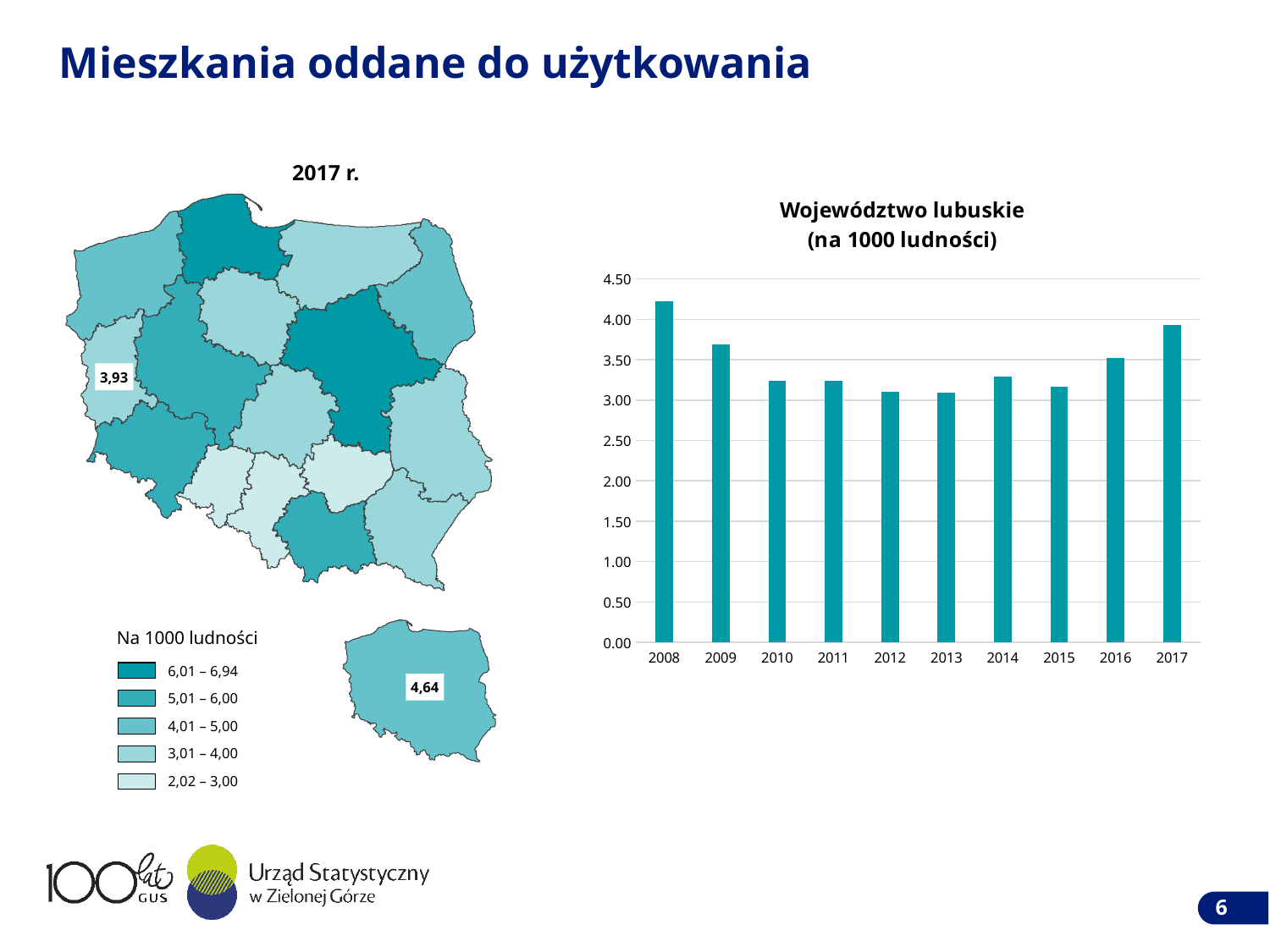
In the 'Województwo lubuskie' bar chart, do the values generally rise or fall from 2013 to 2017? rise In the 'Województwo lubuskie' bar chart, is the value for 2008 greater or less than 4.00? greater How many years are shown on the x axis of the 'Województwo lubuskie' bar chart? 10 In the 'Województwo lubuskie' bar chart, do the values generally rise or fall from 2008 to 2013? fall In the 'Województwo lubuskie' bar chart, is the value for 2009 greater or less than 3.50? greater In the 'Województwo lubuskie' bar chart, is the value for 2010 greater or less than 3.50? less In the 'Województwo lubuskie' bar chart, which is larger, the value for 2014 or the value for 2012? 2014 In the 'Województwo lubuskie' bar chart, which year has the highest value? 2008 In the 'Województwo lubuskie' bar chart, which is larger, the value for 2008 or the value for 2017? 2008 What kind of chart is the 'Województwo lubuskie (na 1000 ludności)' chart? bar chart What is the title of the bar chart on the right side of the slide? Województwo lubuskie (na 1000 ludności)